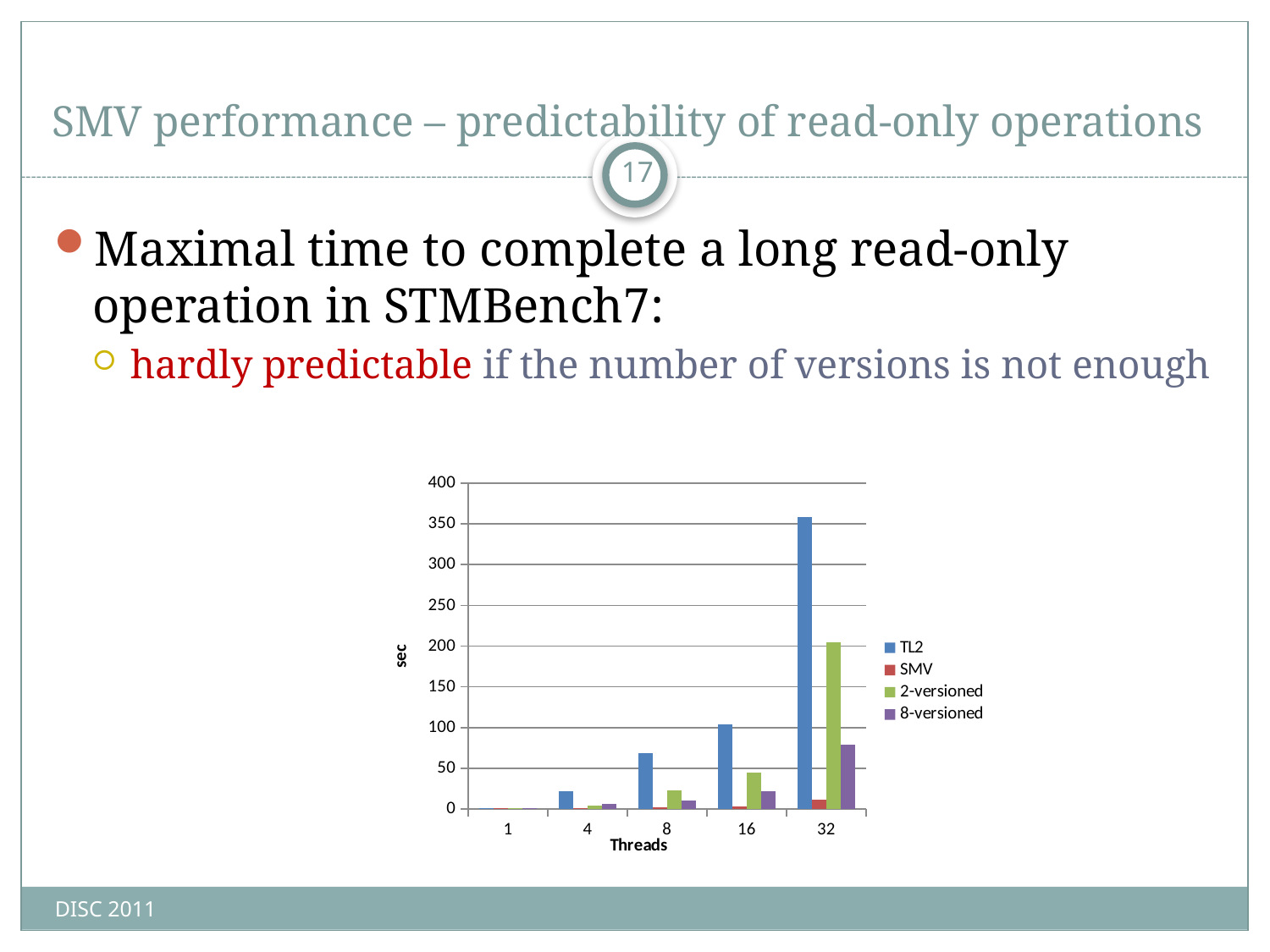
Is the value for 8-versioned at 32 threads greater or less than 100? less Is the value for TL2 at 32 threads greater or less than 300? greater Is the value for TL2 at 8 threads greater or less than 50? greater Which series has the tallest bar at 32 threads? TL2 How many series does the legend list? 4 How many thread counts are shown on the x axis? 5 At 32 threads, which is larger: TL2 or 2-versioned? TL2 Do the TL2 values rise or fall as the number of threads increases? rise What is the label on the y axis? sec What kind of chart is shown on the slide? bar chart